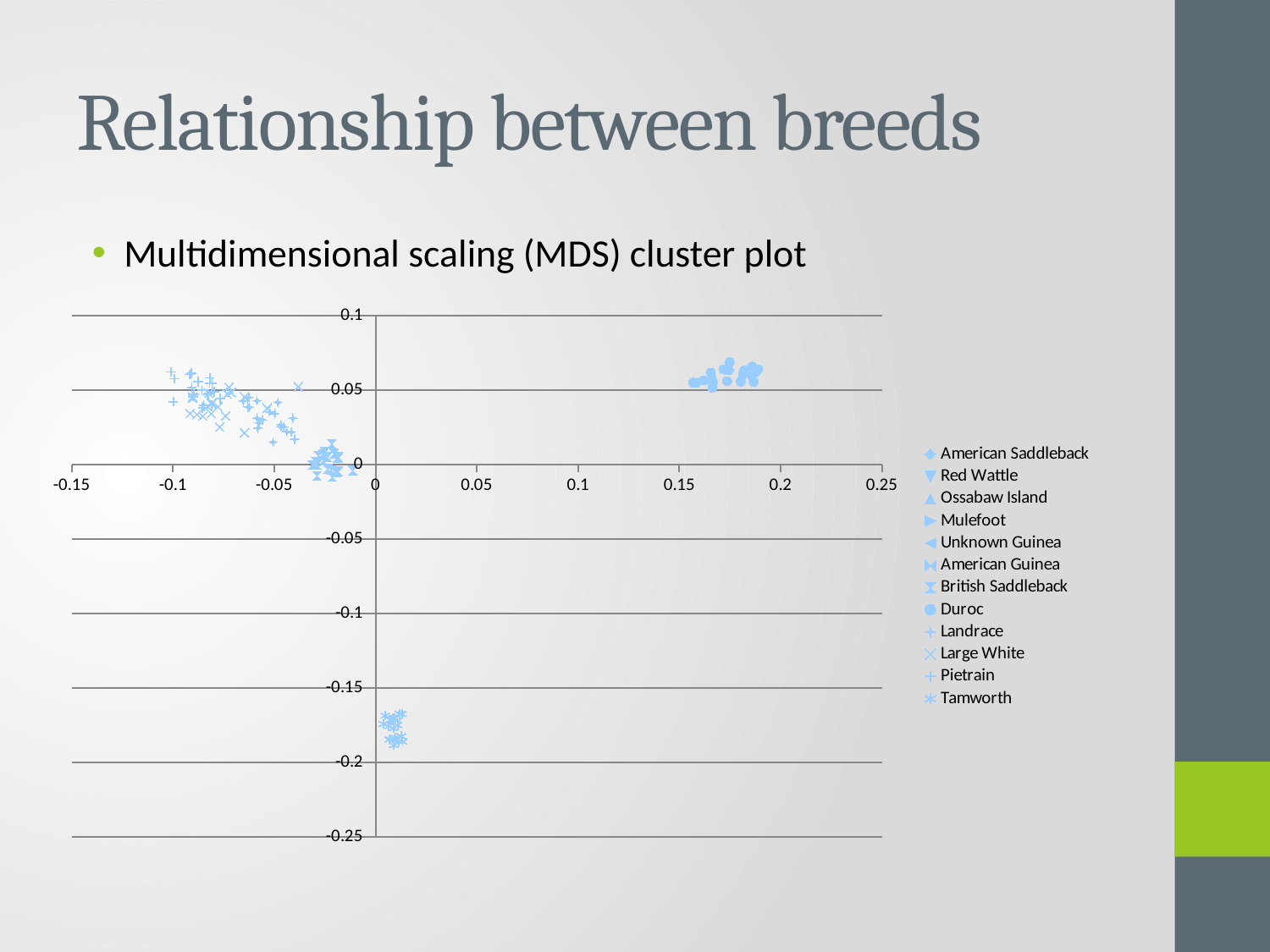
Is the y value of the Duroc cluster of points greater or less than 0? greater Is the y value of the Tamworth cluster of points greater or less than -0.15? less Which breed is listed last in the legend? Tamworth Is the y value of the Tamworth cluster of points greater or less than -0.2? greater What kind of chart is shown on the slide? scatter plot Which breed is listed first in the legend? American Saddleback How many series does the legend list? 12